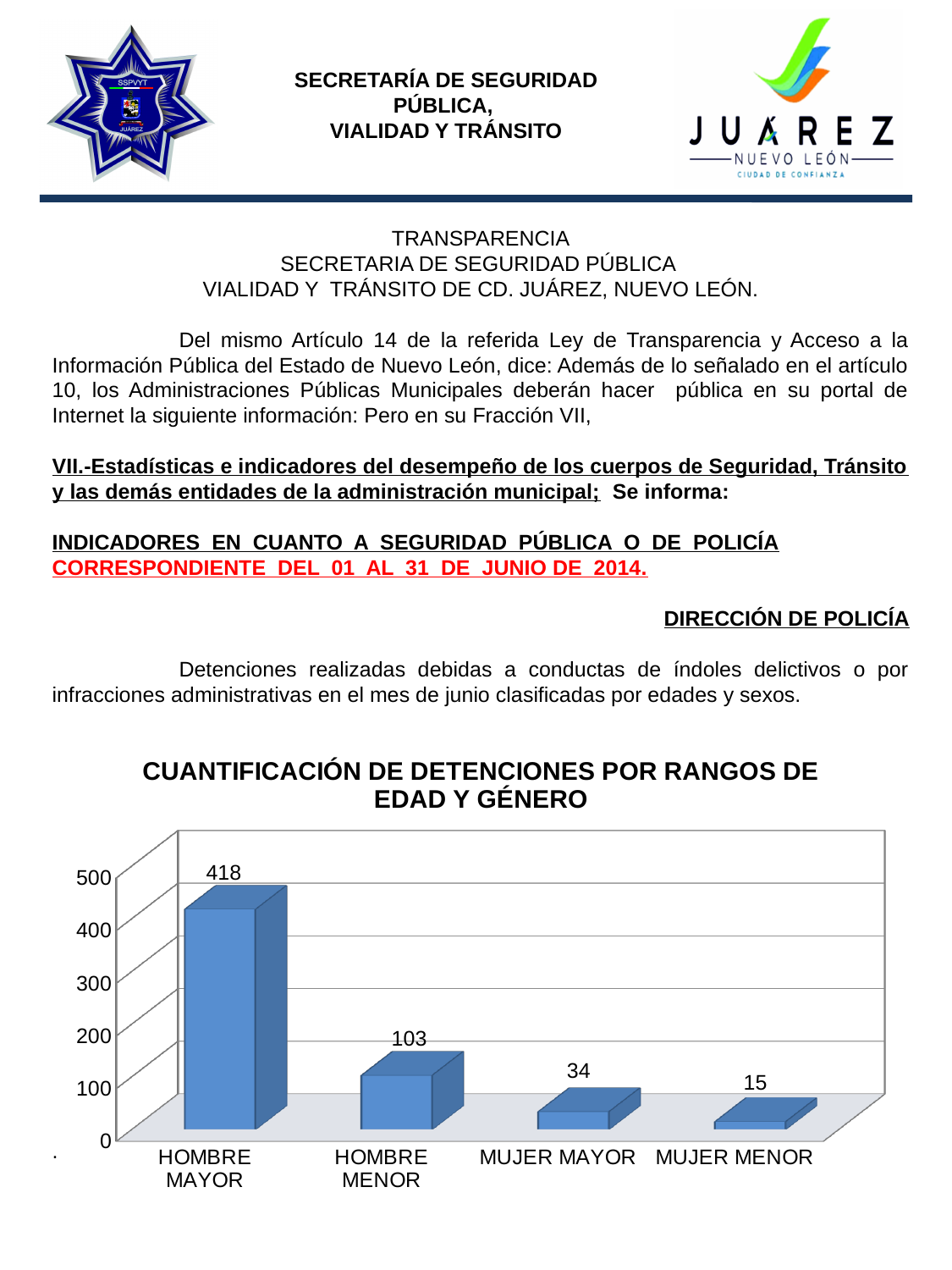
What is the difference between the values for MUJER MAYOR and MUJER MENOR? 19 What is the difference between the values for HOMBRE MAYOR and HOMBRE MENOR? 315 What is the value for HOMBRE MAYOR? 418 Is the value for HOMBRE MAYOR greater or less than 400? greater What is the value for HOMBRE MENOR? 103 What kind of chart is shown on the slide? bar chart What is the value for MUJER MENOR? 15 Which category has the lowest value? MUJER MENOR Which category has the highest value? HOMBRE MAYOR What is the value for MUJER MAYOR? 34 How many categories are shown on the chart? 4 Which is larger, the value for HOMBRE MENOR or the value for MUJER MAYOR? HOMBRE MENOR